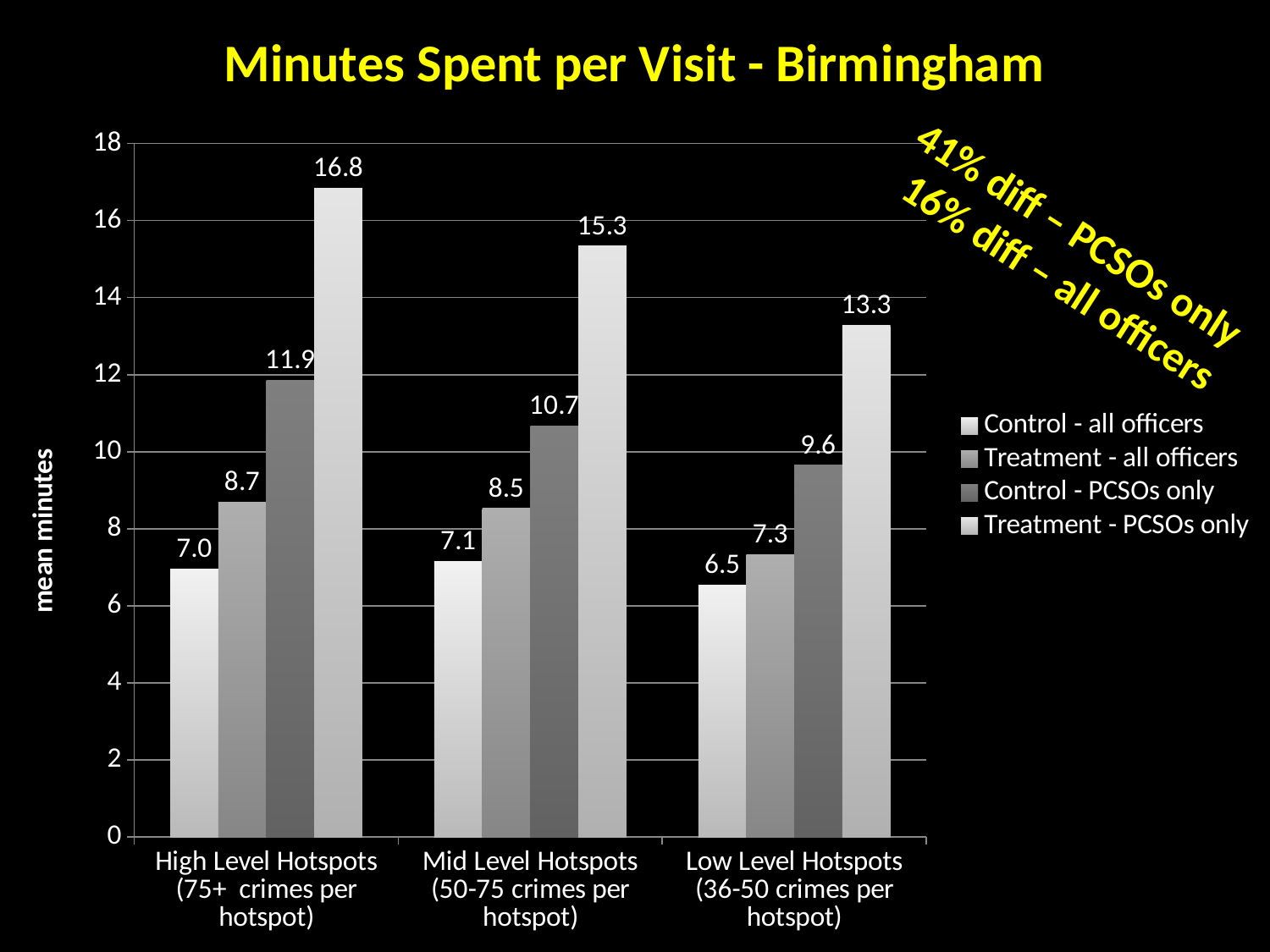
Which is larger in Low Level Hotspots: Control - PCSOs only or Treatment - all officers? Control - PCSOs only Which category has the highest value for Treatment - PCSOs only? High Level Hotspots How many hotspot categories are shown on the x axis? 3 What kind of chart is shown? bar chart Which category has the lowest value for Treatment - all officers? Low Level Hotspots Is the value for Treatment - PCSOs only in Low Level Hotspots greater or less than 12? greater What is the difference between Treatment - PCSOs only and Control - PCSOs only in Mid Level Hotspots? 4.6 What is the label of the y axis? mean minutes How many series does the legend list? 4 What is the value for Control - PCSOs only in Mid Level Hotspots? 10.7 What is the value for Control - all officers in Low Level Hotspots? 6.5 What is the value for Treatment - PCSOs only in High Level Hotspots? 16.8